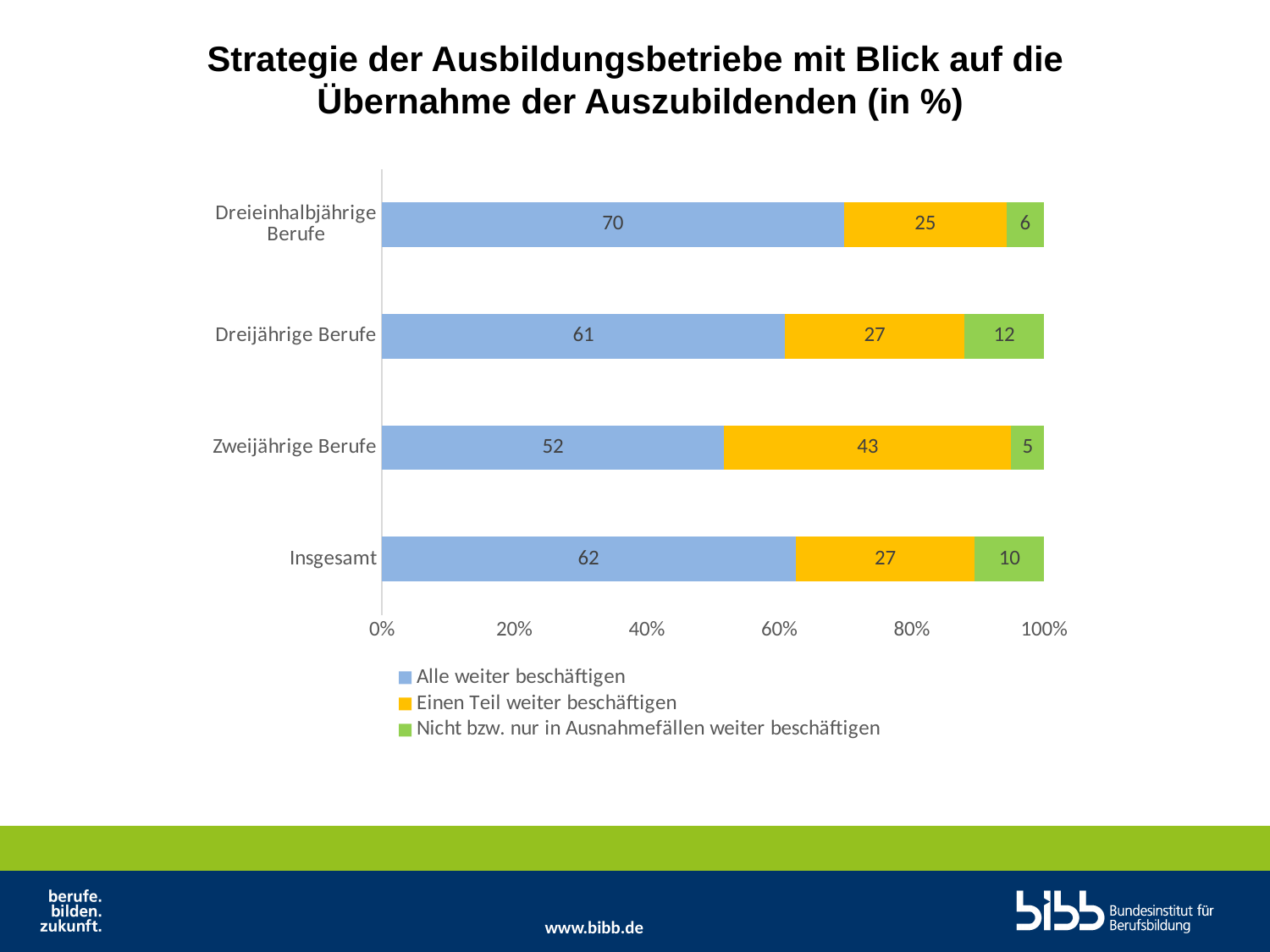
Which category has the lowest value for "Nicht bzw. nur in Ausnahmefällen weiter beschäftigen"? Zweijährige Berufe What is the total of the stacked bar for Dreijährige Berufe? 100 What kind of chart is shown on the slide? Stacked bar chart What is the value for "Alle weiter beschäftigen" for Dreieinhalbjährige Berufe? 70 What is the value for "Einen Teil weiter beschäftigen" for Zweijährige Berufe? 43 What is the value for "Nicht bzw. nur in Ausnahmefällen weiter beschäftigen" for Insgesamt? 10 Which colour represents "Einen Teil weiter beschäftigen" in the legend? Yellow Which is larger: the "Einen Teil weiter beschäftigen" value for Zweijährige Berufe or for Dreijährige Berufe? Zweijährige Berufe How many series does the legend list? 3 What is the difference between the "Alle weiter beschäftigen" values for Dreieinhalbjährige Berufe and Zweijährige Berufe? 18 How many categories are shown on the y axis? 4 Which category has the highest value for "Alle weiter beschäftigen"? Dreieinhalbjährige Berufe